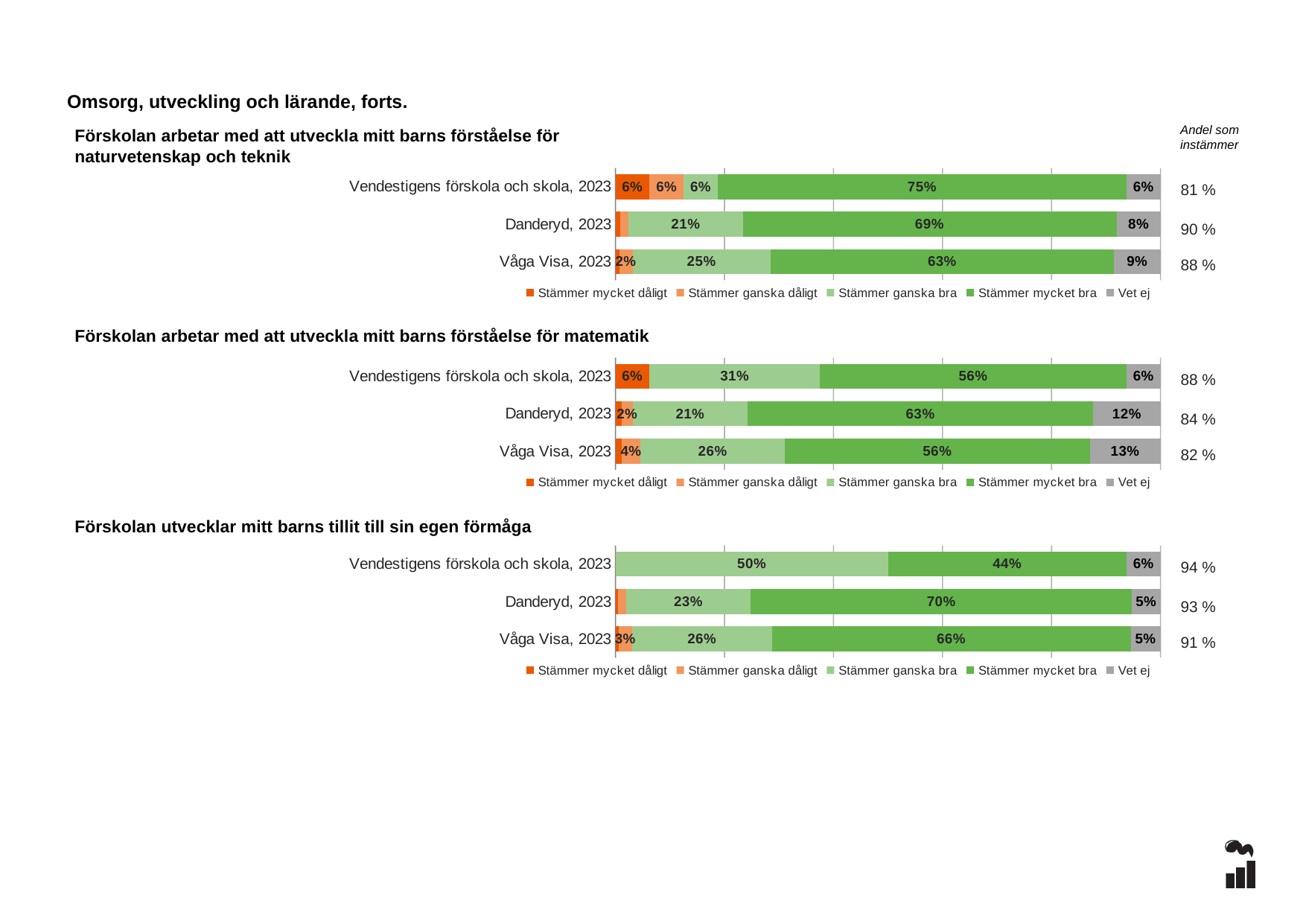
What kind of chart is 'Förskolan arbetar med att utveckla mitt barns förståelse för naturvetenskap och teknik'? Stacked bar chart In the chart 'Förskolan utvecklar mitt barns tillit till sin egen förmåga', which is larger: the 'Stämmer mycket bra' value for Danderyd, 2023 or for Våga Visa, 2023? Danderyd, 2023 In the chart 'Förskolan arbetar med att utveckla mitt barns förståelse för naturvetenskap och teknik', what is the 'Stämmer mycket bra' value for Vendestigens förskola och skola, 2023? 75% In the chart 'Förskolan arbetar med att utveckla mitt barns förståelse för matematik', what is the 'Stämmer ganska bra' value for Vendestigens förskola och skola, 2023? 31% In the chart 'Förskolan arbetar med att utveckla mitt barns förståelse för matematik', which row has the lowest 'Vet ej' value? Vendestigens förskola och skola, 2023 In the chart 'Förskolan utvecklar mitt barns tillit till sin egen förmåga', what is the 'Andel som instämmer' value for Vendestigens förskola och skola, 2023? 94 % In the chart 'Förskolan utvecklar mitt barns tillit till sin egen förmåga', what is the 'Stämmer ganska bra' value for Vendestigens förskola och skola, 2023? 50% How many series does the legend list for the chart 'Förskolan arbetar med att utveckla mitt barns förståelse för matematik'? 5 In the chart 'Förskolan arbetar med att utveckla mitt barns förståelse för naturvetenskap och teknik', which row has the highest 'Stämmer mycket bra' value? Vendestigens förskola och skola, 2023 In the chart 'Förskolan arbetar med att utveckla mitt barns förståelse för matematik', what is the difference between the 'Stämmer mycket bra' values for Danderyd, 2023 and Våga Visa, 2023? 7% How many rows (categories) are shown in the chart 'Förskolan utvecklar mitt barns tillit till sin egen förmåga'? 3 In the chart 'Förskolan arbetar med att utveckla mitt barns förståelse för naturvetenskap och teknik', what is the 'Vet ej' value for Våga Visa, 2023? 9%